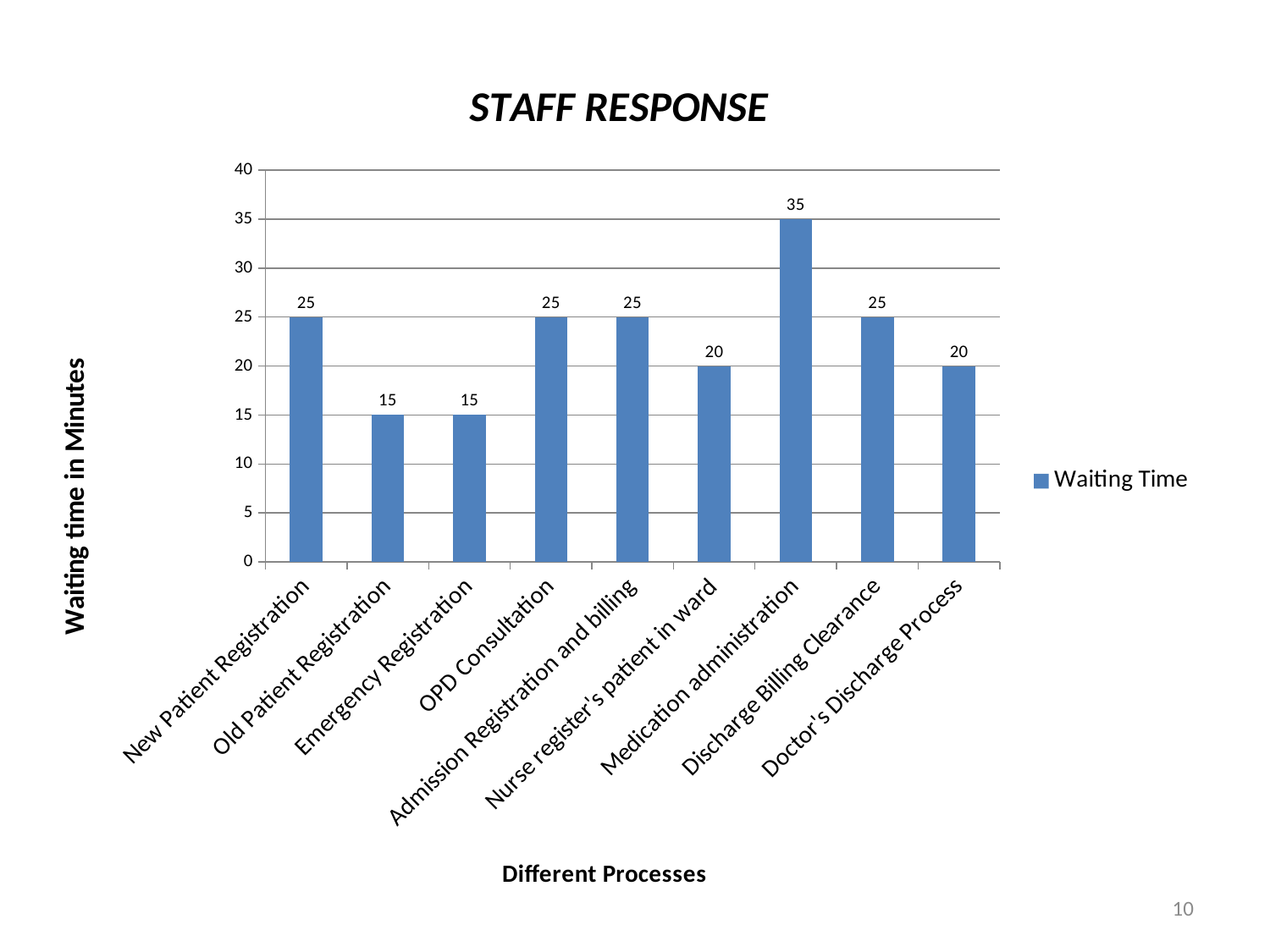
What is the waiting time for Medication administration? 35 What kind of chart is shown on the slide? Bar chart Which process has the highest waiting time? Medication administration What is the label of the y axis? Waiting time in Minutes What is the waiting time for Old Patient Registration? 15 How many series does the legend list? 1 Which has a longer waiting time, OPD Consultation or Doctor's Discharge Process? OPD Consultation What is the difference in waiting time between New Patient Registration and Old Patient Registration? 10 What is the title of the chart? STAFF RESPONSE How many processes are shown on the x axis? 9 What is the waiting time for Nurse register's patient in ward? 20 What is the difference in waiting time between Medication administration and Emergency Registration? 20